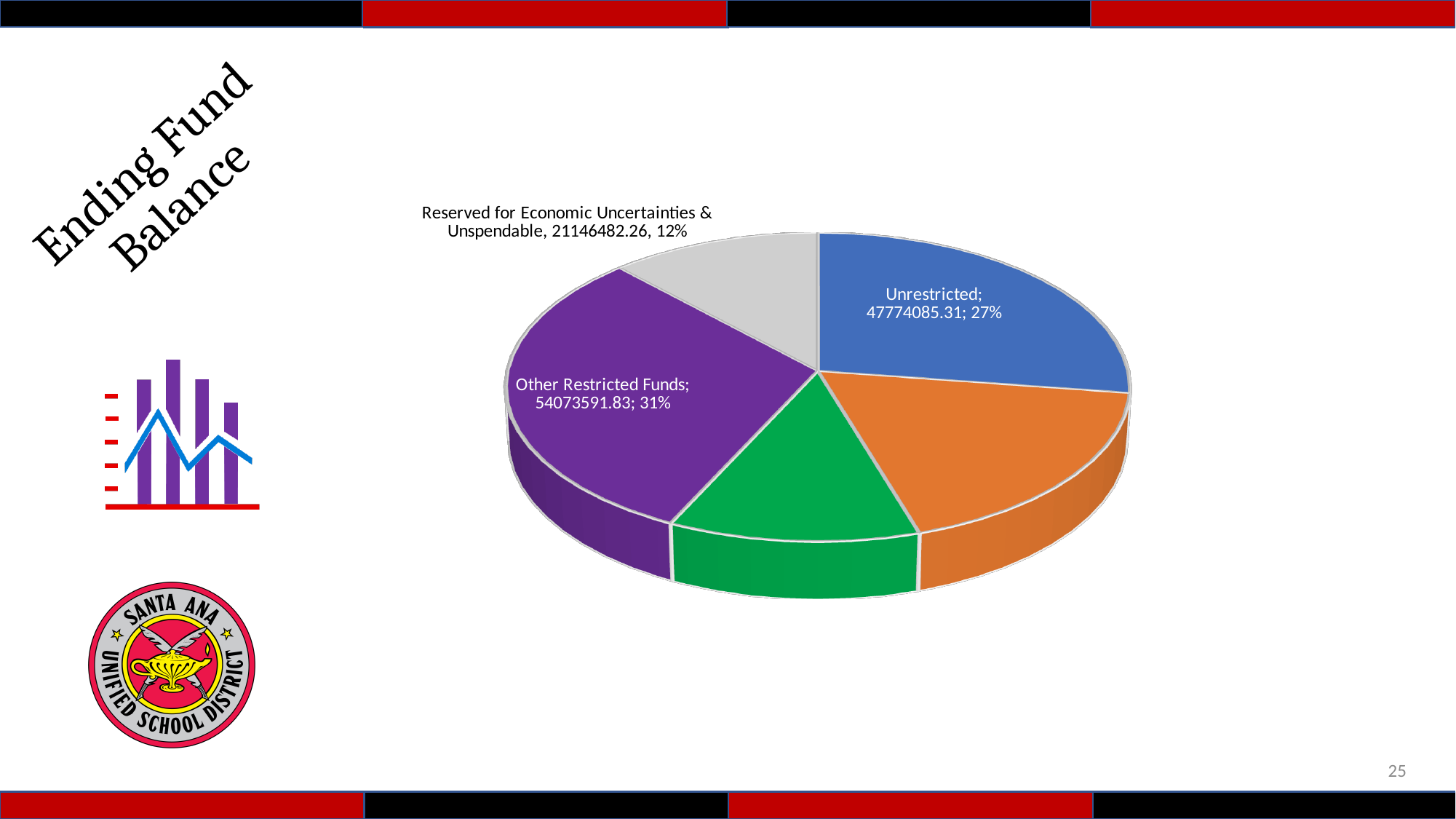
What kind of chart is shown on the slide? pie chart What value is shown for the Other Restricted Funds slice? 54073591.83 How many slices does the pie chart have? 5 What share of the pie does the Other Restricted Funds slice represent? 31% What share of the pie does the Unrestricted slice represent? 27% What is the difference in percentage share between Other Restricted Funds and Unrestricted? 4% Which is larger, the Unrestricted slice or the Other Restricted Funds slice? Other Restricted Funds What value is shown for the Reserved for Economic Uncertainties & Unspendable slice? 21146482.26 What share of the pie does the Reserved for Economic Uncertainties & Unspendable slice represent? 12% What colour is the Other Restricted Funds slice? purple What is the difference between the Other Restricted Funds value and the Unrestricted value? 6299506.52 What value is shown for the Unrestricted slice of the pie chart? 47774085.31